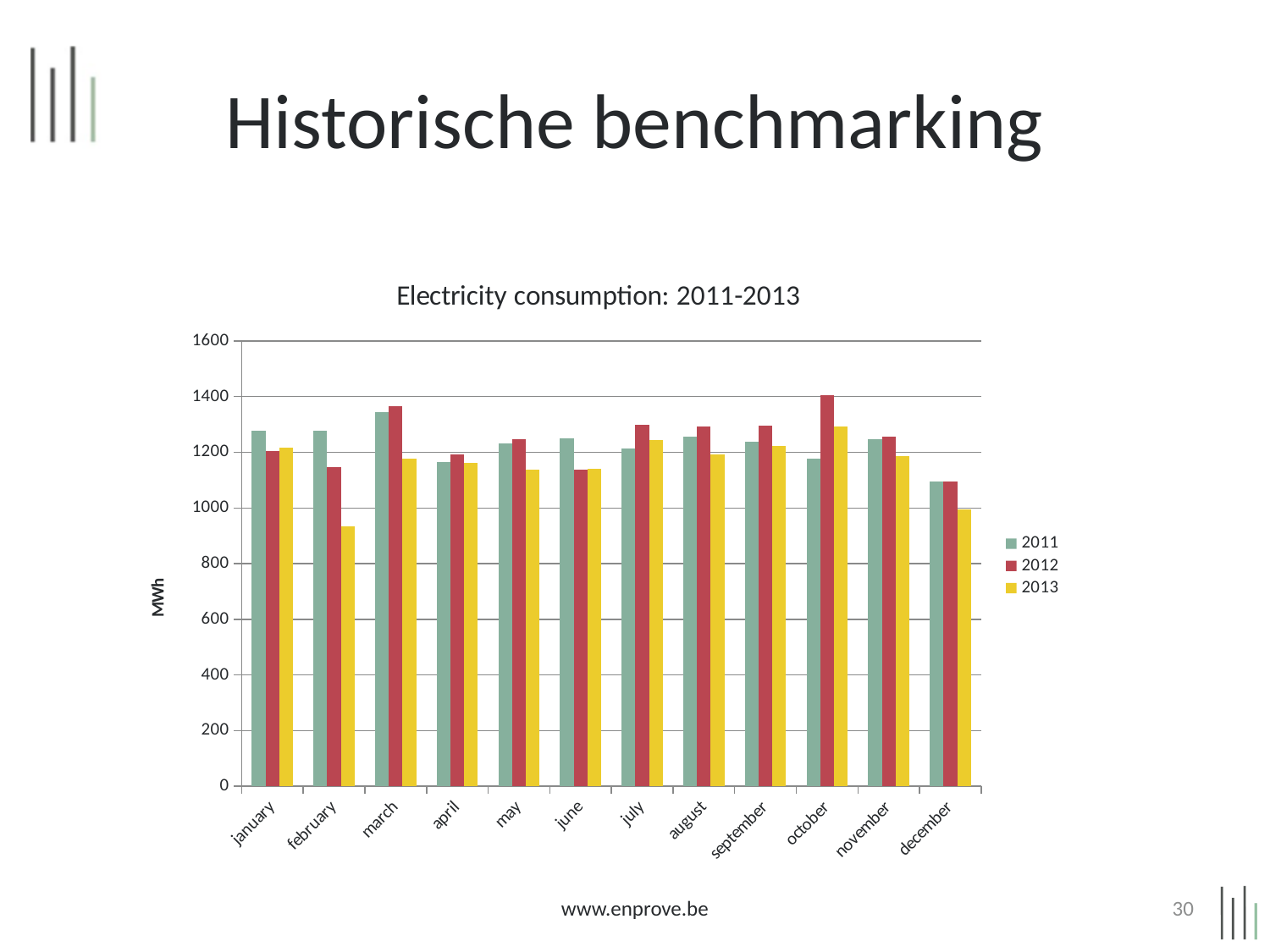
How many months are shown on the x axis? 12 In october, which is larger: the 2011 value or the 2012 value? 2012 Is the 2013 value for february greater or less than 1000? less How many series does the legend list? 3 What is the title of the chart? Electricity consumption: 2011-2013 In which month is the 2013 value lowest? february Is the 2011 value for december greater or less than 1200? less What kind of chart is shown on the slide? bar chart In which month is the 2012 value highest? october In february, which is larger: the 2011 value or the 2013 value? 2011 Is the 2012 value for october greater or less than 1200? greater What unit is shown on the vertical axis label? MWh